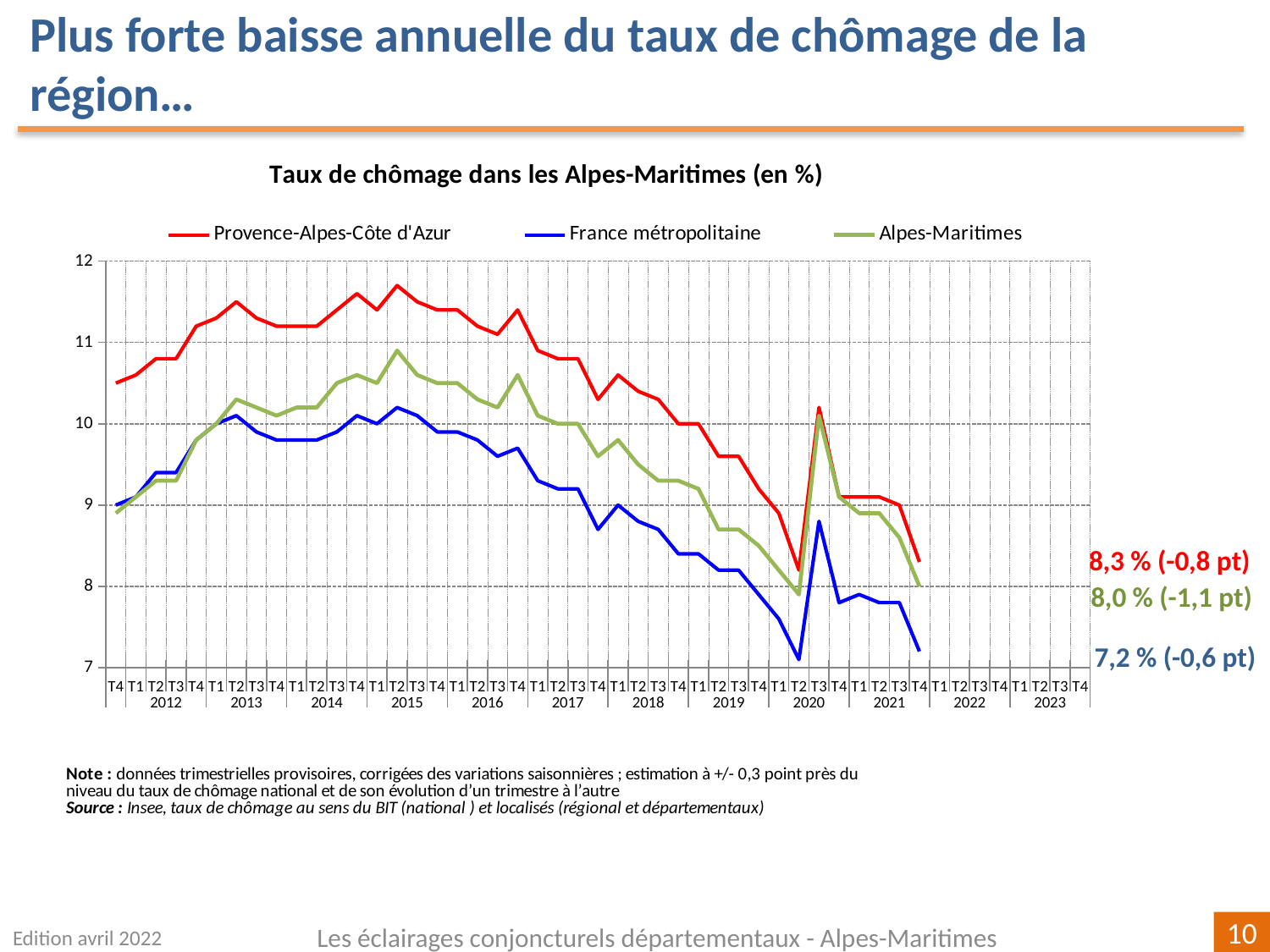
How many series does the legend list? 3 Does the Alpes-Maritimes unemployment rate rise or fall between 2015 and 2019? fall What is the difference between the latest values for Provence-Alpes-Côte d'Azur and France métropolitaine? 1,1 pt What kind of chart is shown on the slide? line chart Which series has the highest latest value? Provence-Alpes-Côte d'Azur What is the title of the chart? Taux de chômage dans les Alpes-Maritimes (en %) What is the latest unemployment rate shown for Alpes-Maritimes? 8,0 % Is the value for France métropolitaine at T2 2020 greater or less than 8? less What is the latest unemployment rate shown for France métropolitaine? 7,2 % What annual change is shown next to the Alpes-Maritimes final value? -1,1 pt Which series has the lowest latest value? France métropolitaine What is the latest unemployment rate shown for Provence-Alpes-Côte d'Azur? 8,3 %